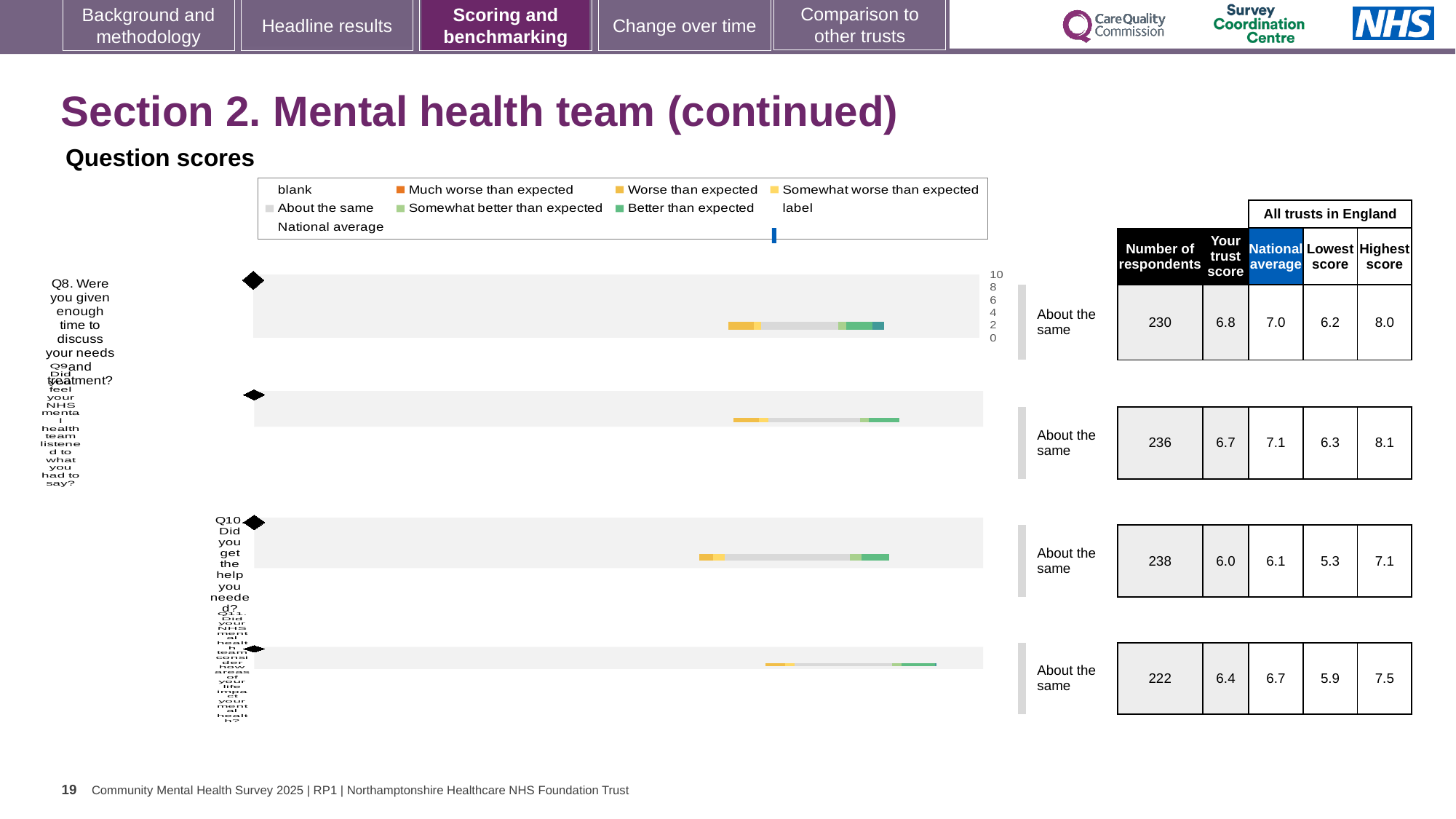
For Q9, how much higher is the national average than the trust score? 0.4 How many questions are charted on this slide? 4 How many respondents answered Q9 (Did you feel your NHS mental health team listened to what you had to say?)? 236 For Q11, which is larger: the trust score or the national average? National average What benchmark category is shown for Q8? About the same What is the highest score across all trusts in England for Q11? 7.5 What kind of chart is used to show the question scores? Bar chart For Q8, what is the difference between the highest score and the lowest score across all trusts in England? 1.8 What is the national average score for Q10 (Did you get the help you needed?)? 6.1 Which question has the highest national average score on this slide? Q9 What is the trust score for Q8 (Were you given enough time to discuss your needs and treatment?)? 6.8 Which question has the lowest trust score on this slide? Q10